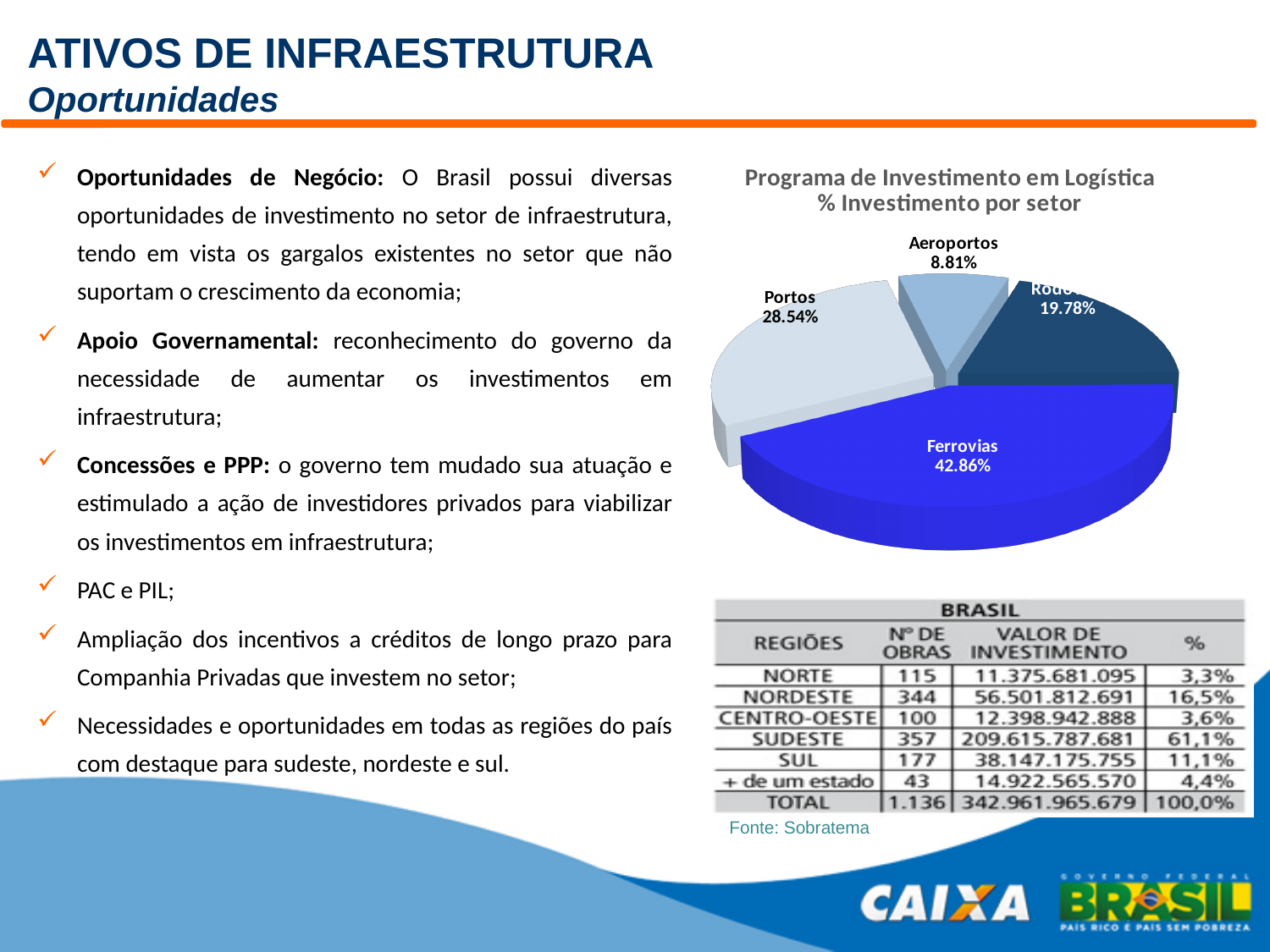
Which sector has the smallest slice of the pie chart? Aeroportos What is the title of the pie chart? Programa de Investimento em Logística % Investimento por setor Which is larger in the pie chart, Portos or Aeroportos? Portos What is the value shown for Aeroportos in the pie chart? 8.81% What share of investment does the Ferrovias slice represent? 42.86% How many slices does the pie chart have? 4 Which slice of the pie chart is coloured bright blue? Ferrovias What is the value shown for Portos in the pie chart? 28.54% Which sector has the largest slice of the pie chart? Ferrovias What is the difference in percentage points between Portos and Aeroportos? 19.73 What is the difference in percentage points between Ferrovias and Portos? 14.32 What kind of chart is shown on the slide? Pie chart